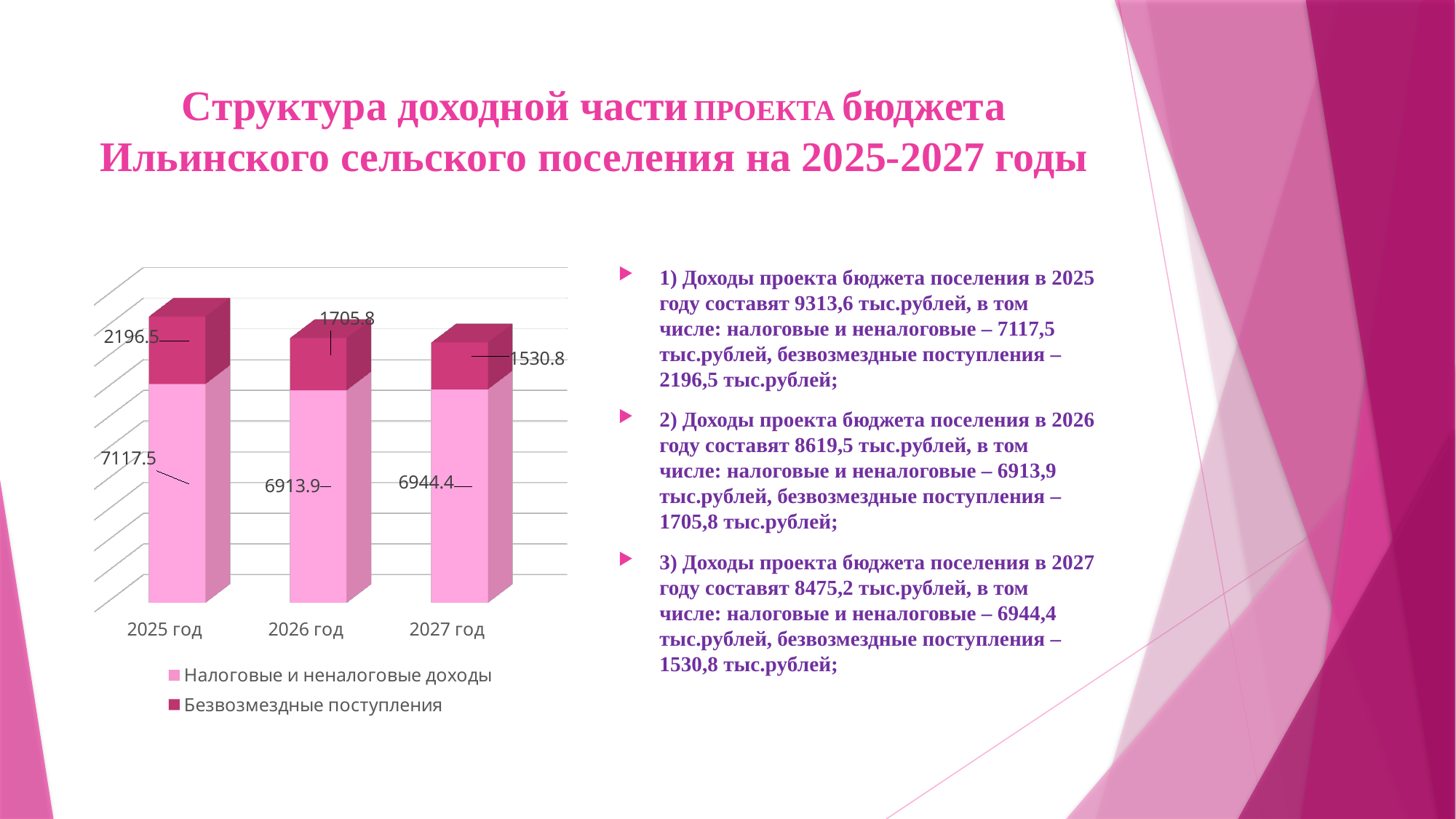
What is the value of Налоговые и неналоговые доходы for 2025 год? 7117.5 What is the total of the stacked bar for 2027 год? 8475.2 How many year categories are shown on the x axis of the chart? 3 What is the difference between Налоговые и неналоговые доходы in 2025 год and 2026 год? 203.6 In which year is the value of Налоговые и неналоговые доходы the lowest? 2026 год What type of chart is shown on the slide? bar chart How many series does the chart legend list? 2 Do the values of Безвозмездные поступления rise or fall from 2025 год to 2027 год? fall What is the value of Безвозмездные поступления for 2027 год? 1530.8 What is the value of Безвозмездные поступления for 2026 год? 1705.8 In which year is the value of Безвозмездные поступления the highest? 2025 год Which is larger: Безвозмездные поступления in 2026 год or in 2027 год? 2026 год